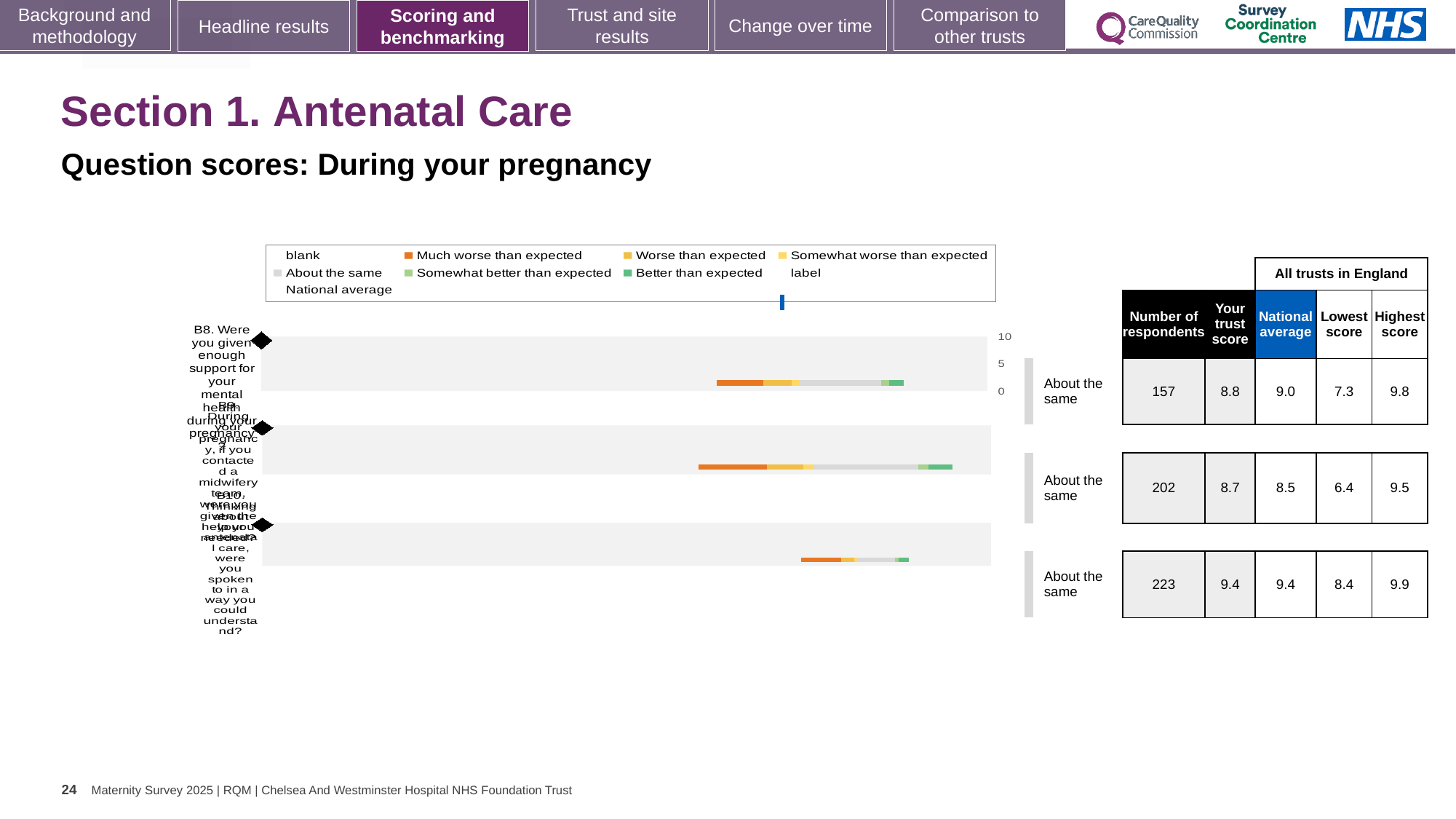
What is the highest score across all trusts in England for the first row (B8)? 9.8 For the third row, what is the difference between the highest score and the lowest score across all trusts in England? 1.5 What is the number of respondents for the first row (B8, support for your mental health during pregnancy)? 157 What kind of chart is shown on the slide? Bar chart Which legend entry is shown in orange? Much worse than expected What is the lowest score across all trusts in England for the second row? 6.4 What is the national average for the first row (B8)? 9.0 How many question rows (bars) are plotted in the chart? 3 Which row has the highest 'Your trust score'? The third row (9.4) What is the trust score for the first row (B8, support for your mental health during pregnancy)? 8.8 What benchmark category is given for all three question rows? About the same For the second row, which is larger: the trust score or the national average? The trust score (8.7)